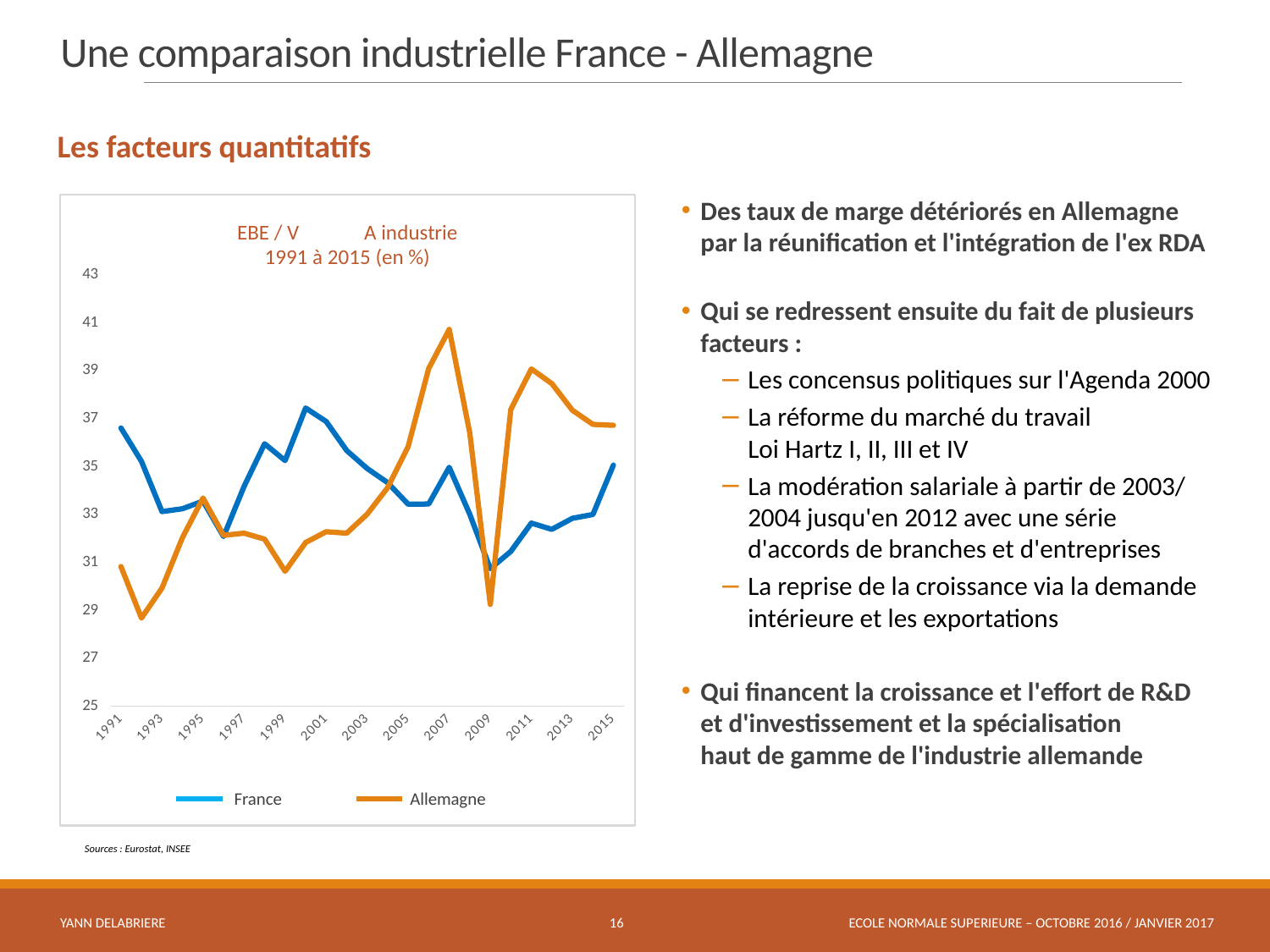
In which year does the Allemagne series reach its highest value? 2007 In 2007, which series has the higher value, France or Allemagne? Allemagne Is the value for France in 1991 greater or less than 35? greater In which year does the France series reach its lowest value? 2009 Which two series are listed in the chart legend? France and Allemagne In 1999, which series has the higher value, France or Allemagne? France What period does the chart title say the data covers? 1991 à 2015 Is the value for Allemagne in 2007 greater or less than 39? greater Is the value for Allemagne in 1992 greater or less than 31? less How many series does the chart legend list? 2 Does the Allemagne series rise or fall between 2011 and 2015? fall What kind of chart is shown on the slide? line chart